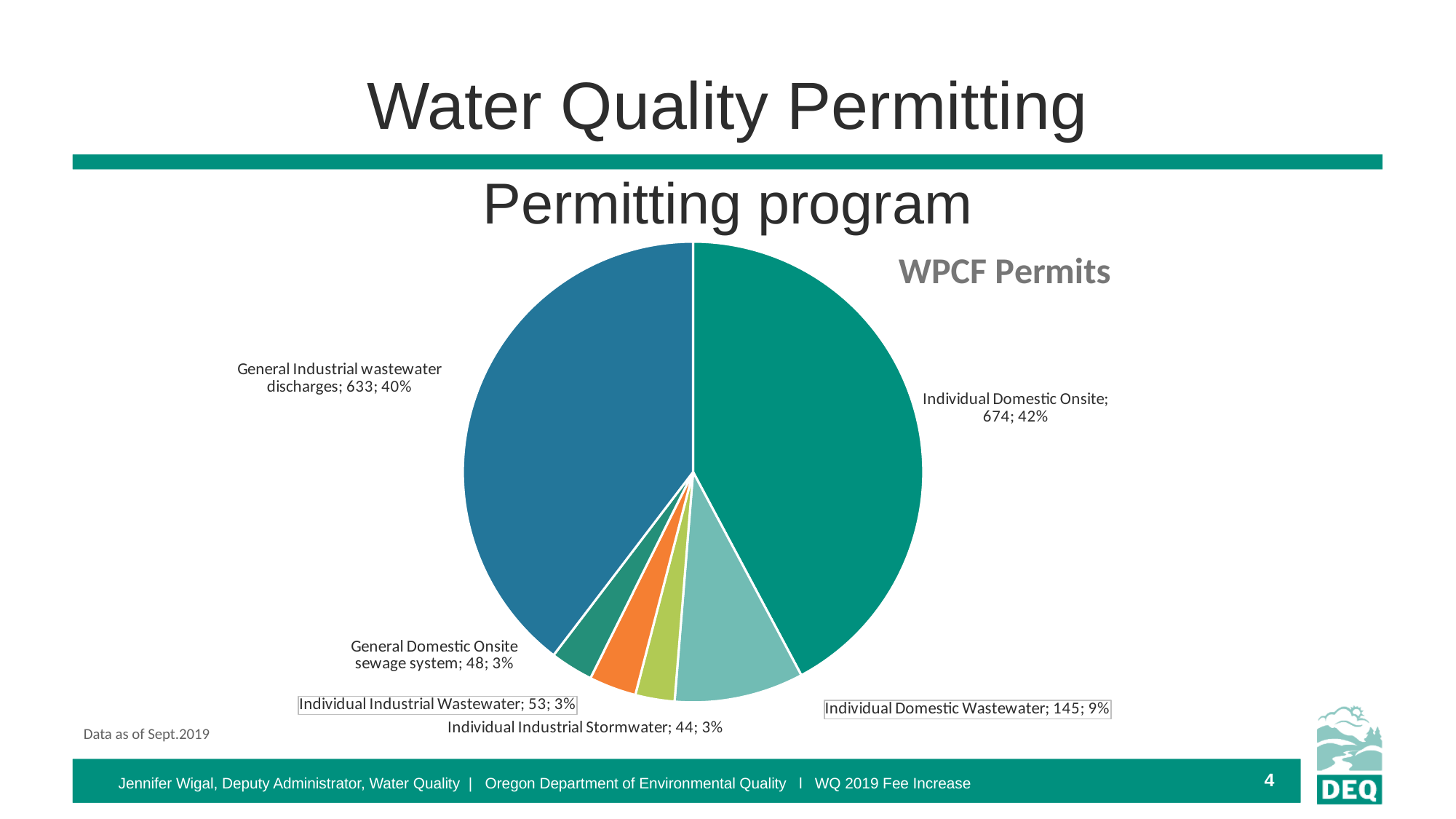
What share of the pie does Individual Domestic Wastewater represent? 9% What is the value for Individual Industrial Stormwater? 44 What share of the pie does General Industrial wastewater discharges represent? 40% How many slices does the pie chart have? 6 What is the difference between the values for Individual Domestic Onsite and General Industrial wastewater discharges? 41 Which is larger, the value for Individual Industrial Wastewater or the value for General Domestic Onsite sewage system? Individual Industrial Wastewater Which category has the smallest slice of the pie? Individual Industrial Stormwater What is the value for Individual Domestic Wastewater? 145 What is the value for General Industrial wastewater discharges? 633 What kind of chart is shown on the slide? pie chart What is the value for Individual Domestic Onsite? 674 Which category has the largest slice of the pie? Individual Domestic Onsite